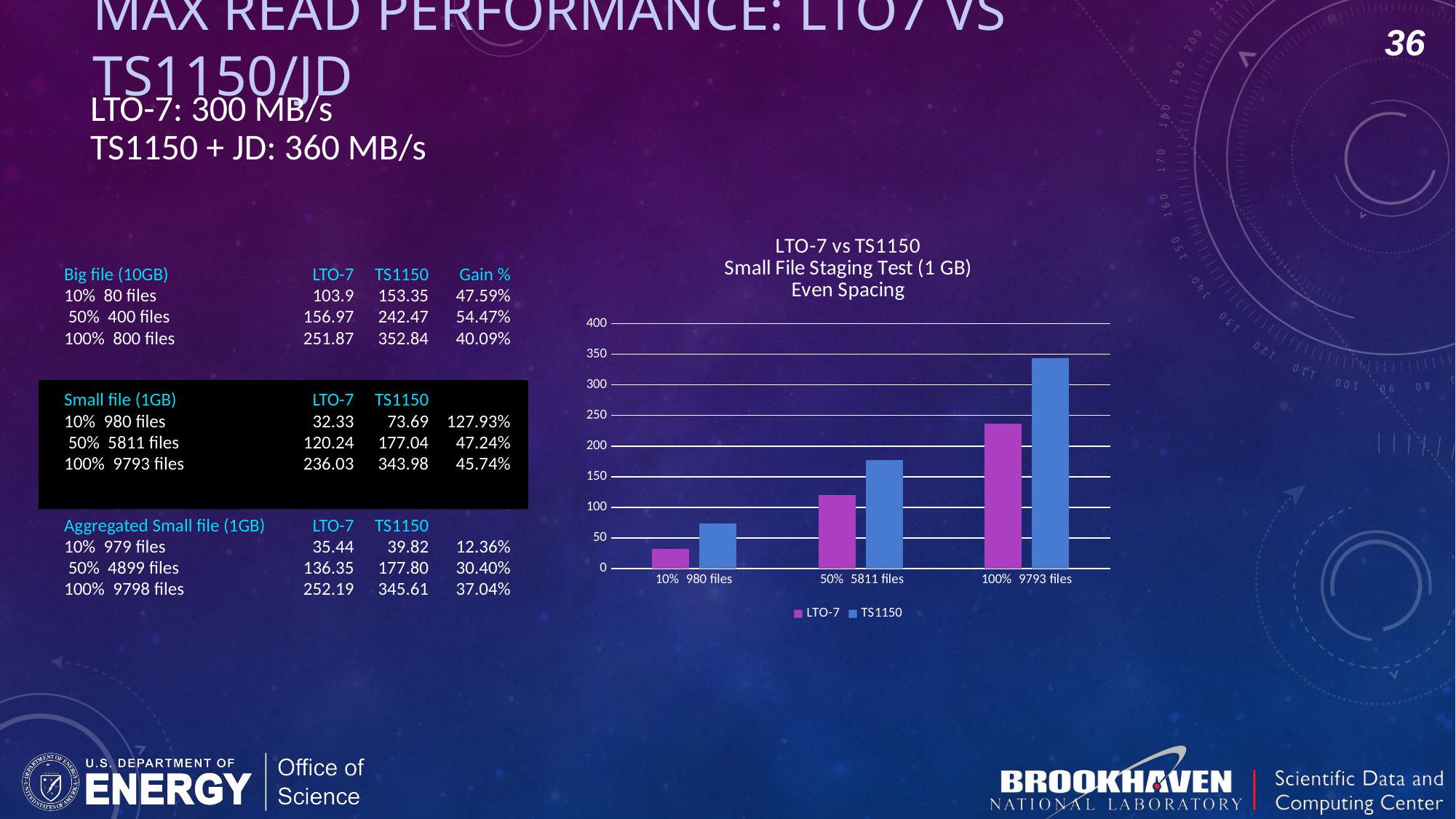
Which category has the lowest LTO-7 bar? 10% 980 files Is the TS1150 value for 100% 9793 files greater or less than 300? greater How many series does the chart's legend list? 2 Is the LTO-7 value for 100% 9793 files greater or less than 200? greater What is the title of the chart? LTO-7 vs TS1150 Small File Staging Test (1 GB) Even Spacing Do the LTO-7 values rise or fall from left to right along the x axis? rise Is the LTO-7 value for 10% 980 files greater or less than 50? less How many categories are shown on the x axis of the chart? 3 For 50% 5811 files, which series has the larger bar, LTO-7 or TS1150? TS1150 What kind of chart is shown on the slide? bar chart Which category has the highest TS1150 bar? 100% 9793 files